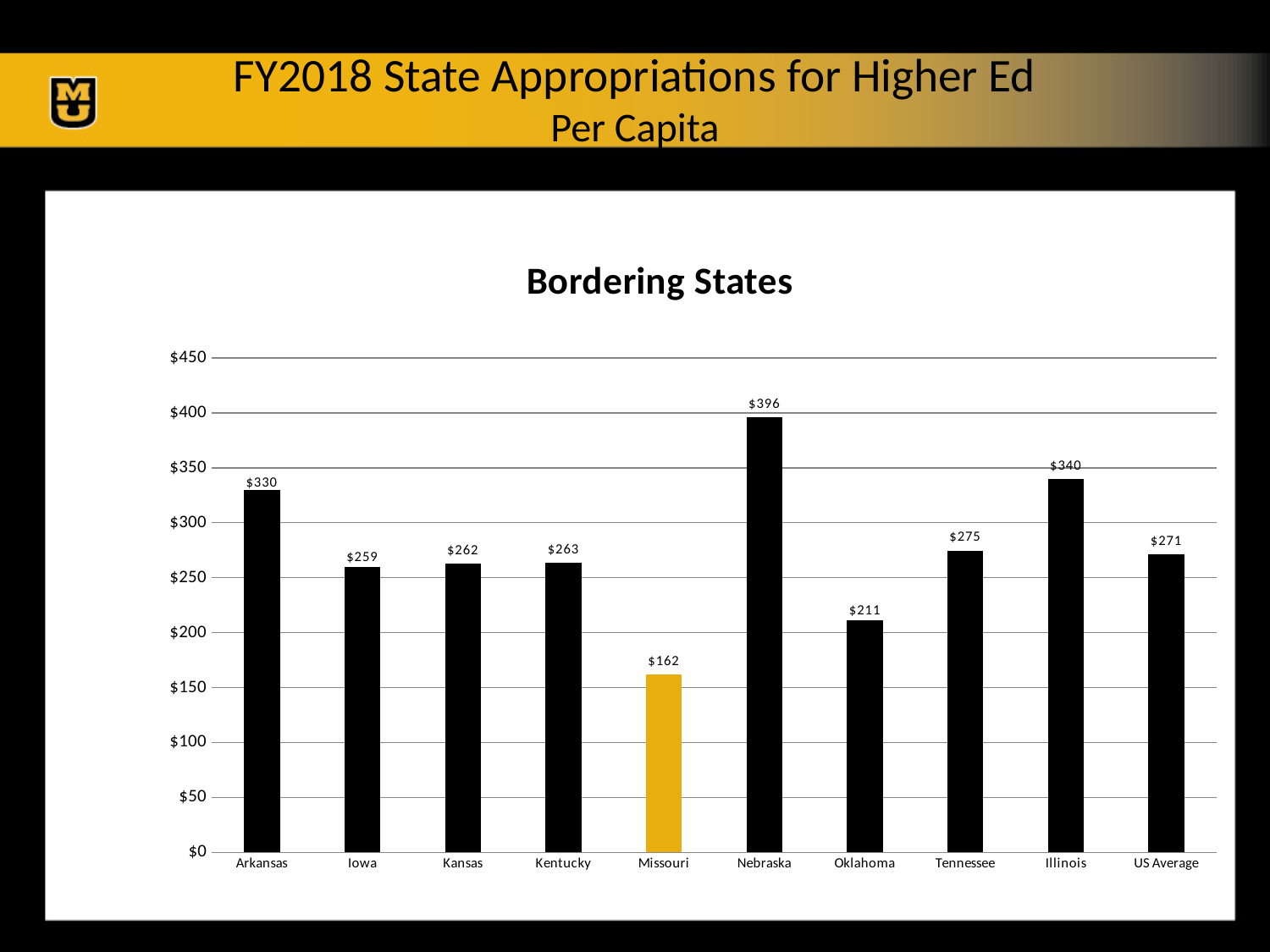
Is the value for Arkansas greater or less than $300? greater What is the value for US Average? $271 Which category has the highest value? Nebraska Which is larger, the value for Oklahoma or the value for Tennessee? Tennessee Which category has the lowest value? Missouri What is the difference between the values for Nebraska and Missouri? $234 What is the difference between the values for Illinois and Arkansas? $10 What is the value for Nebraska? $396 What kind of chart is shown on the slide? Bar chart How many categories are shown on the x axis? 10 What is the title of the chart? Bordering States What is the value for Missouri? $162